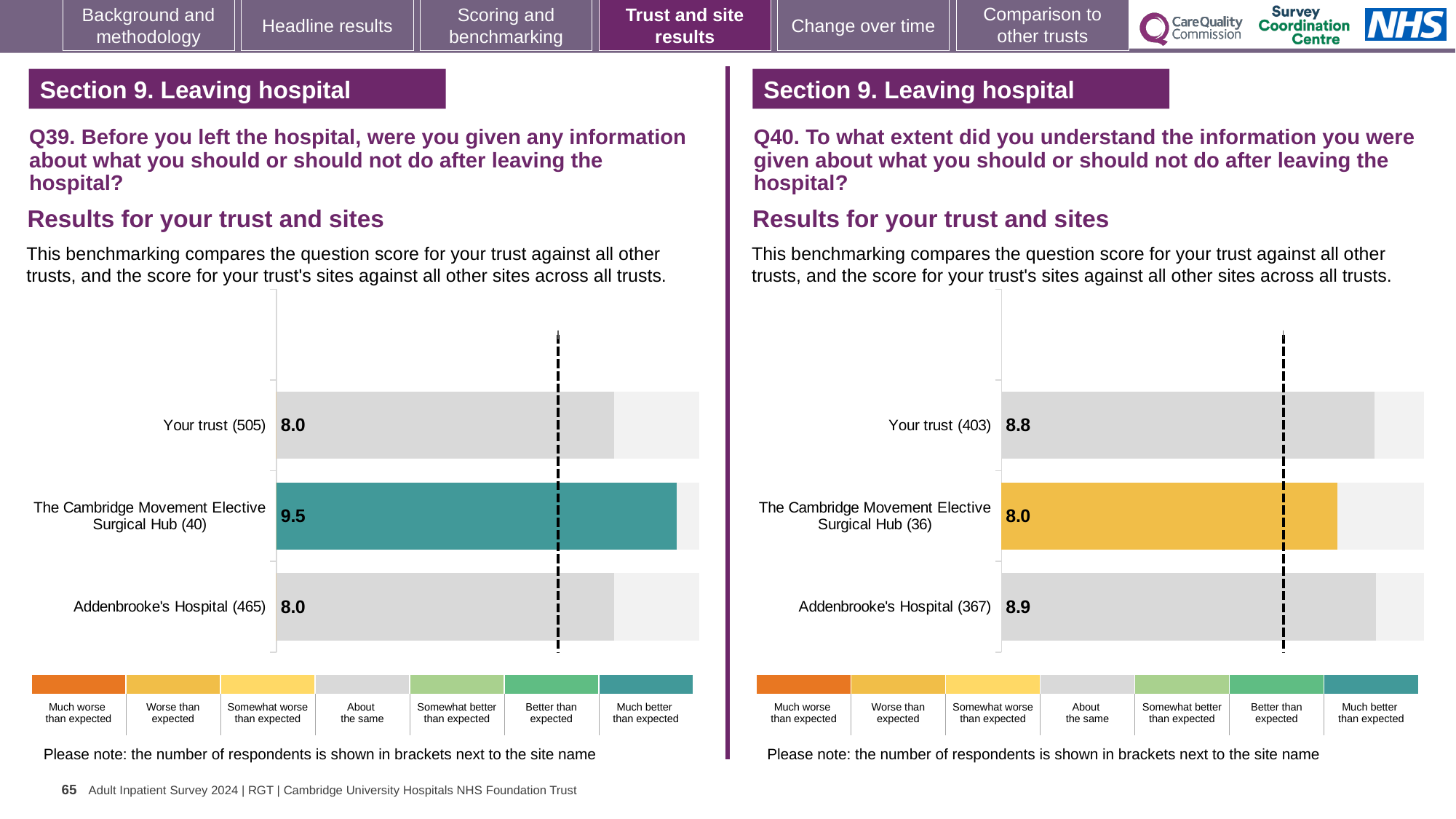
In the Q39 chart on the left, which site or trust has the highest score? The Cambridge Movement Elective Surgical Hub (40) In the Q40 chart on the right, which benchmark category does the colour of the bar for The Cambridge Movement Elective Surgical Hub (36) correspond to in the legend? Worse than expected In the Q40 chart on the right, is the score for Your trust (403) larger or smaller than the score for The Cambridge Movement Elective Surgical Hub (36)? larger In the Q40 chart on the right, which site or trust has the lowest score? The Cambridge Movement Elective Surgical Hub (36) In the Q40 chart on the right, what is the score for Addenbrooke's Hospital (367)? 8.9 In the Q40 chart on the right, what is the difference between the score for Addenbrooke's Hospital (367) and The Cambridge Movement Elective Surgical Hub (36)? 0.9 In the Q40 chart on the right, what is the score for Your trust (403)? 8.8 In the Q39 chart on the left, what is the score for Your trust (505)? 8.0 How many bars are plotted in the Q39 chart on the left? 3 What kind of chart is the Q40 chart on the right? bar chart In the Q39 chart on the left, what is the difference between the score for The Cambridge Movement Elective Surgical Hub (40) and Addenbrooke's Hospital (465)? 1.5 In the Q39 chart on the left, what is the score for The Cambridge Movement Elective Surgical Hub (40)? 9.5